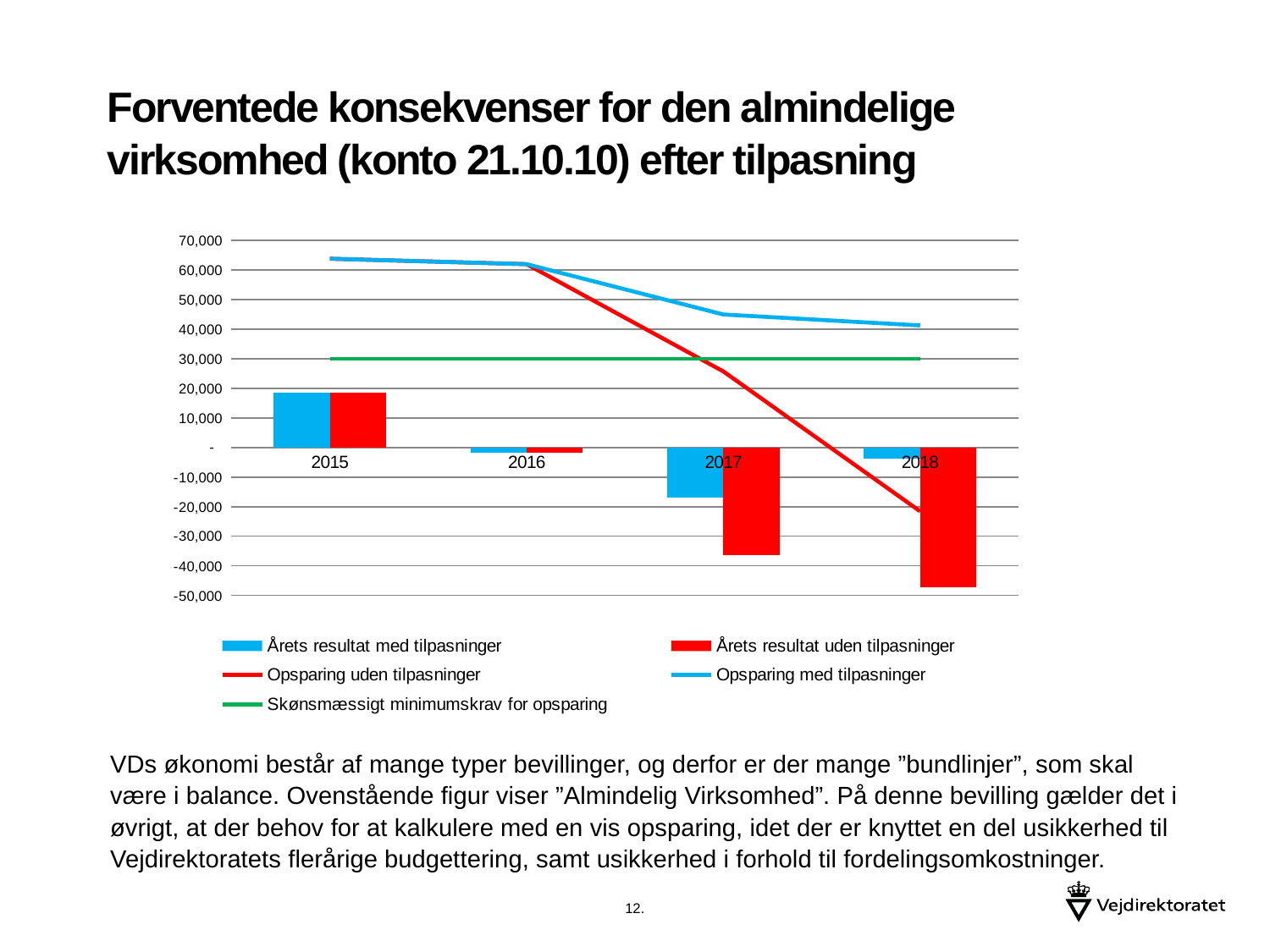
How many years are shown on the x axis of the chart? 4 Is the value for 'Årets resultat uden tilpasninger' in 2018 greater or less than -40,000? less Is the value for 'Opsparing med tilpasninger' in 2018 greater or less than 30,000? greater What value does the 'Skønsmæssigt minimumskrav for opsparing' line hold across all years? 30,000 Does the 'Opsparing med tilpasninger' line rise or fall from 2015 to 2018? Fall In which year is 'Årets resultat med tilpasninger' highest? 2015 Is the value for 'Opsparing uden tilpasninger' in 2018 greater or less than -10,000? less In which year is 'Årets resultat uden tilpasninger' lowest? 2018 In 2017, which is larger: 'Årets resultat med tilpasninger' or 'Årets resultat uden tilpasninger'? Årets resultat med tilpasninger How many series does the chart's legend list? 5 What kind of chart is shown on the slide? A combined bar and line chart